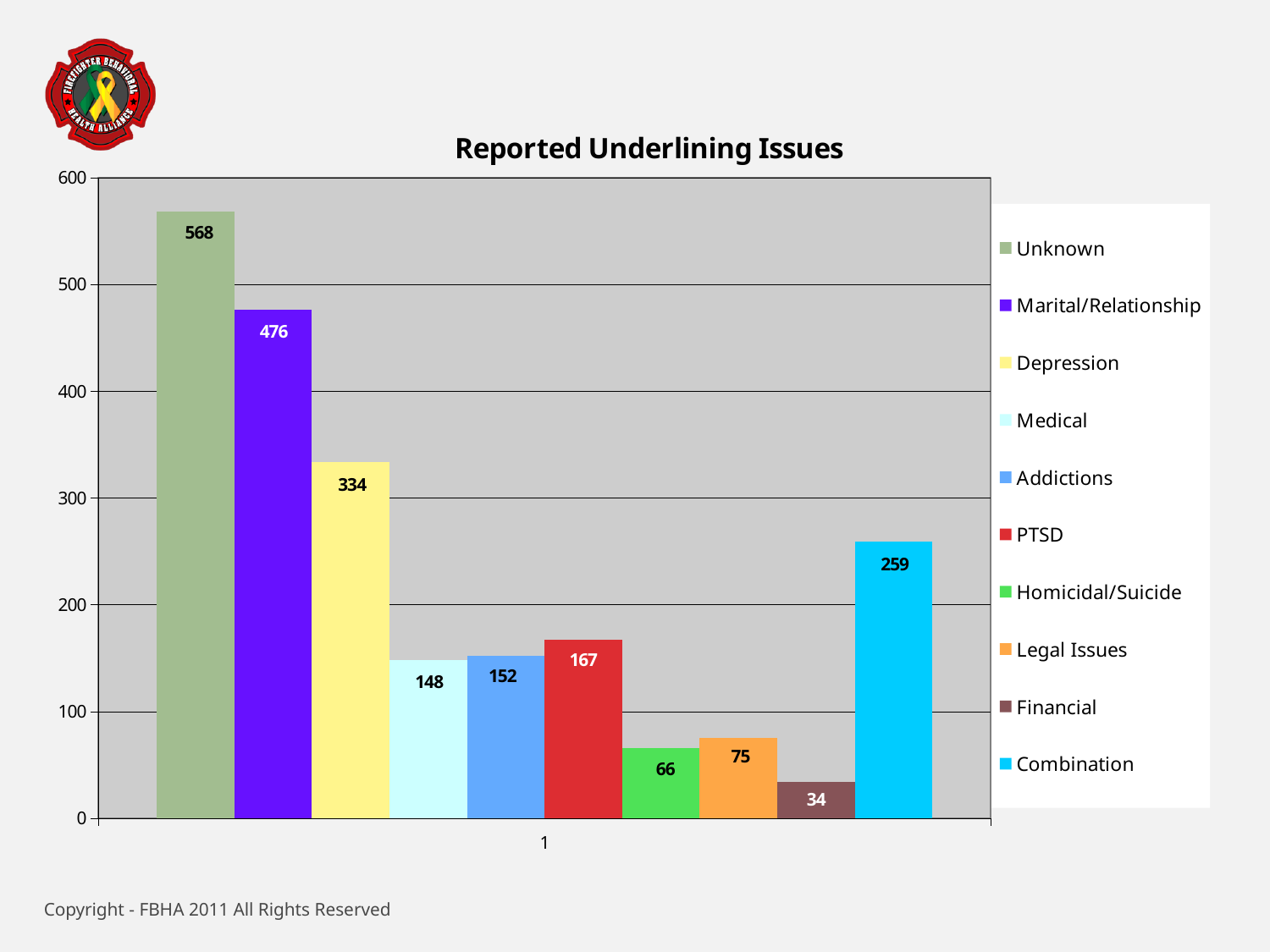
What is the difference between the values for Depression and Medical? 186 Is the value for Addictions greater or less than 200? less What kind of chart is shown on the slide? bar chart What is the title of the chart? Reported Underlining Issues What is the value for Marital/Relationship? 476 Which series has the highest value? Unknown What is the value for Combination? 259 Which series has the lowest value? Financial Which is larger, the value for Legal Issues or the value for Homicidal/Suicide? Legal Issues How many series does the legend list? 10 What is the value for Unknown? 568 What is the value for PTSD? 167